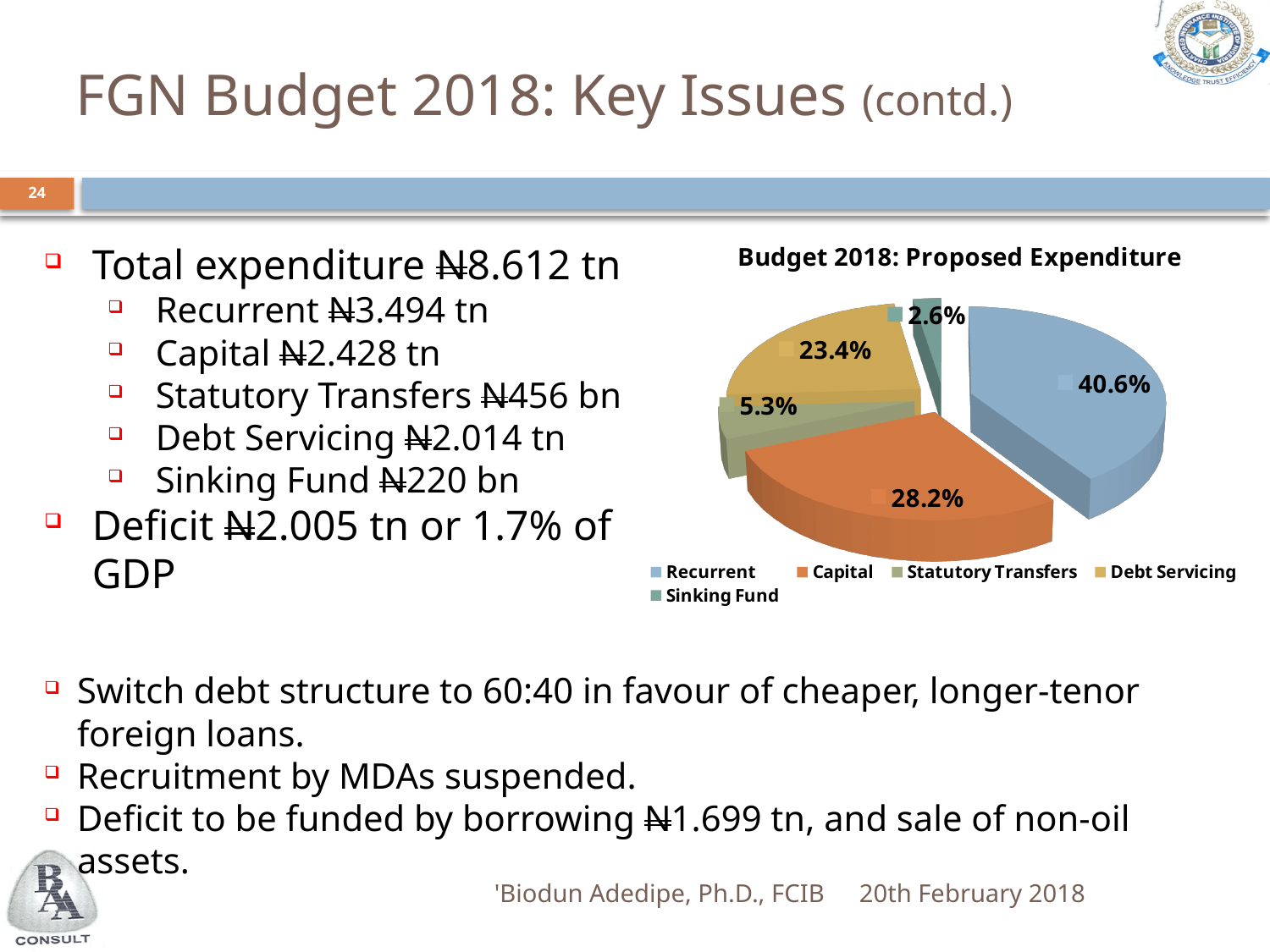
How many categories does the pie chart show? 5 Which slice is larger, Debt Servicing or Statutory Transfers? Debt Servicing What is the title of the chart on the slide? Budget 2018: Proposed Expenditure What share of proposed expenditure does Statutory Transfers account for in the pie chart? 5.3% What share of proposed expenditure does Sinking Fund account for in the pie chart? 2.6% What share of proposed expenditure does Debt Servicing account for in the pie chart? 23.4% Which category has the largest slice in the pie chart? Recurrent What is the difference in percentage points between the Recurrent and Capital slices? 12.4 What kind of chart is shown on the slide? Pie chart Which category has the smallest slice in the pie chart? Sinking Fund